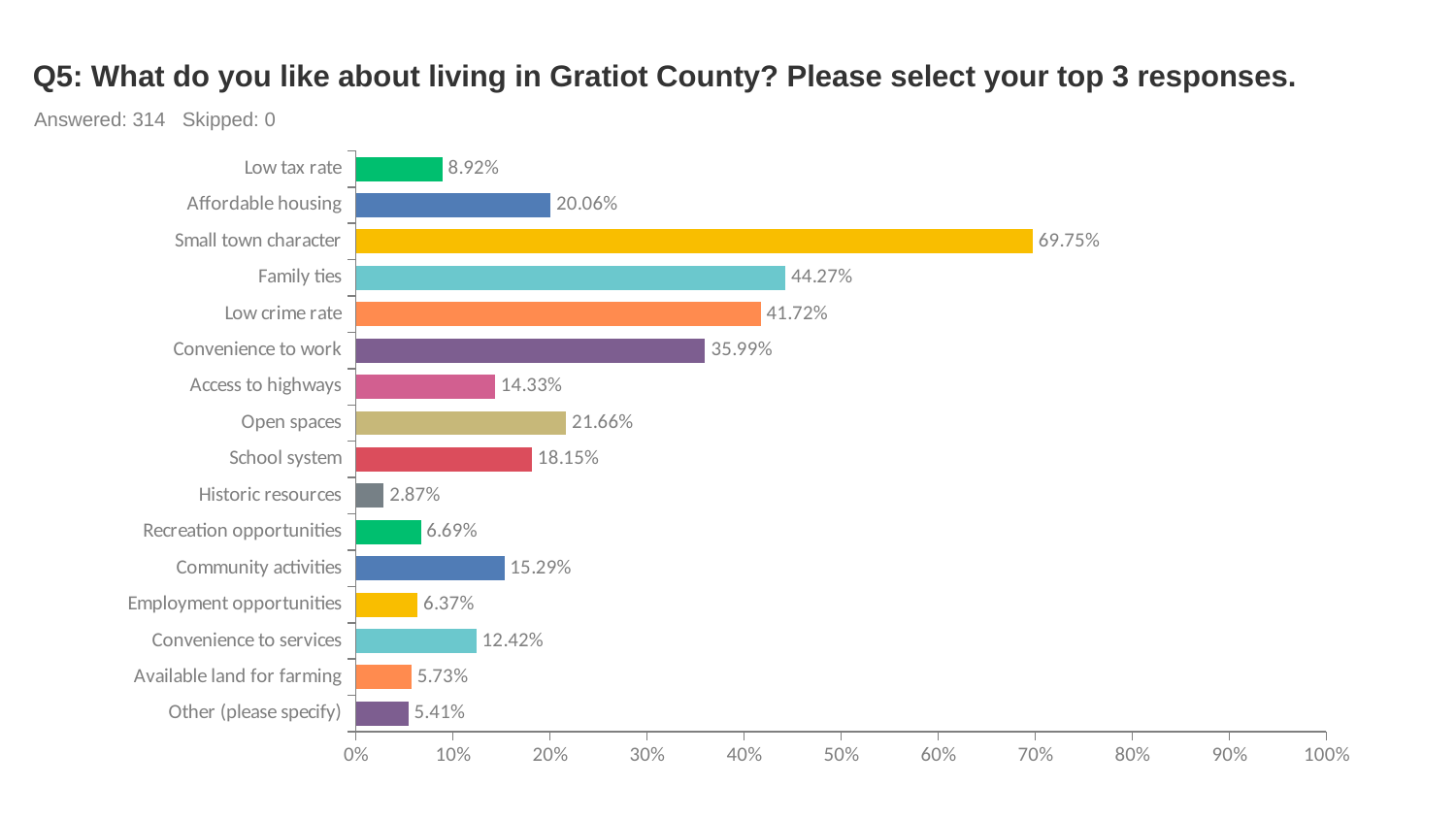
Which category has the lowest value? Historic resources Which is larger, Open spaces or Affordable housing? Open spaces What percentage of respondents selected Small town character? 69.75% Is the value for Convenience to work greater or less than 30%? greater What is the value for Low crime rate? 41.72% How many respondents answered the question? 314 Which category has the highest value? Small town character What percentage is shown for Convenience to services? 12.42% How many categories are shown in the chart? 16 What is the difference between Family ties and Low crime rate? 2.55% What kind of chart is this? Bar chart What is the difference between Small town character and Convenience to work? 33.76%